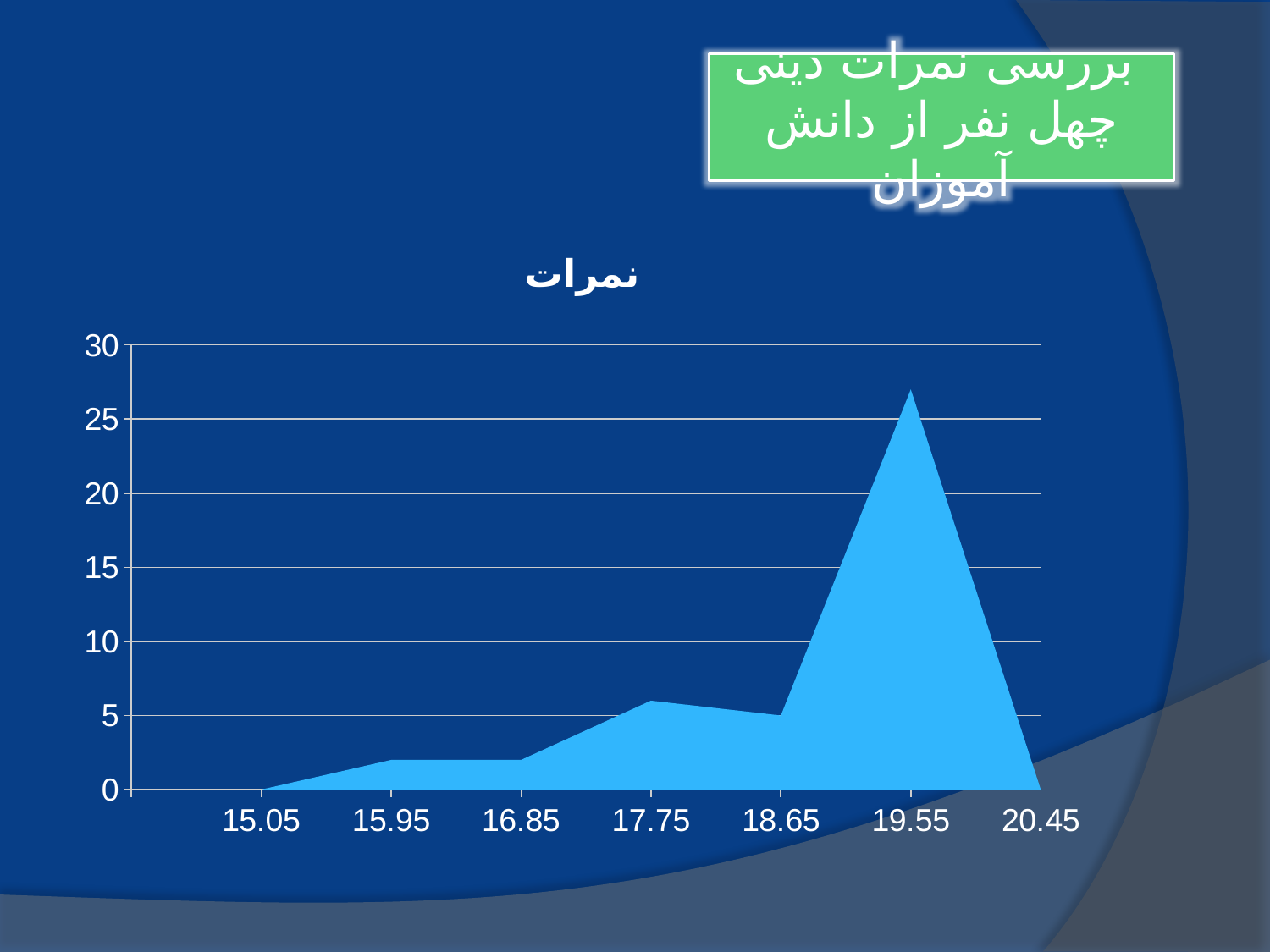
What kind of chart is shown on the slide? area chart How many categories are shown on the x axis of the chart? 7 What is the title of the chart? نمرات What is the value for 15.05 in the chart? 0 Which has the larger value, 17.75 or 15.95? 17.75 Is the value for 15.95 greater or less than 5? less Is the value for 18.65 greater or less than 10? less Do the values rise or fall between 19.55 and 20.45? fall What is the value for 20.45 in the chart? 0 Is the value for 19.55 greater or less than 25? greater Which x-axis category has the highest value in the chart? 19.55 Which has the larger value, 19.55 or 17.75? 19.55